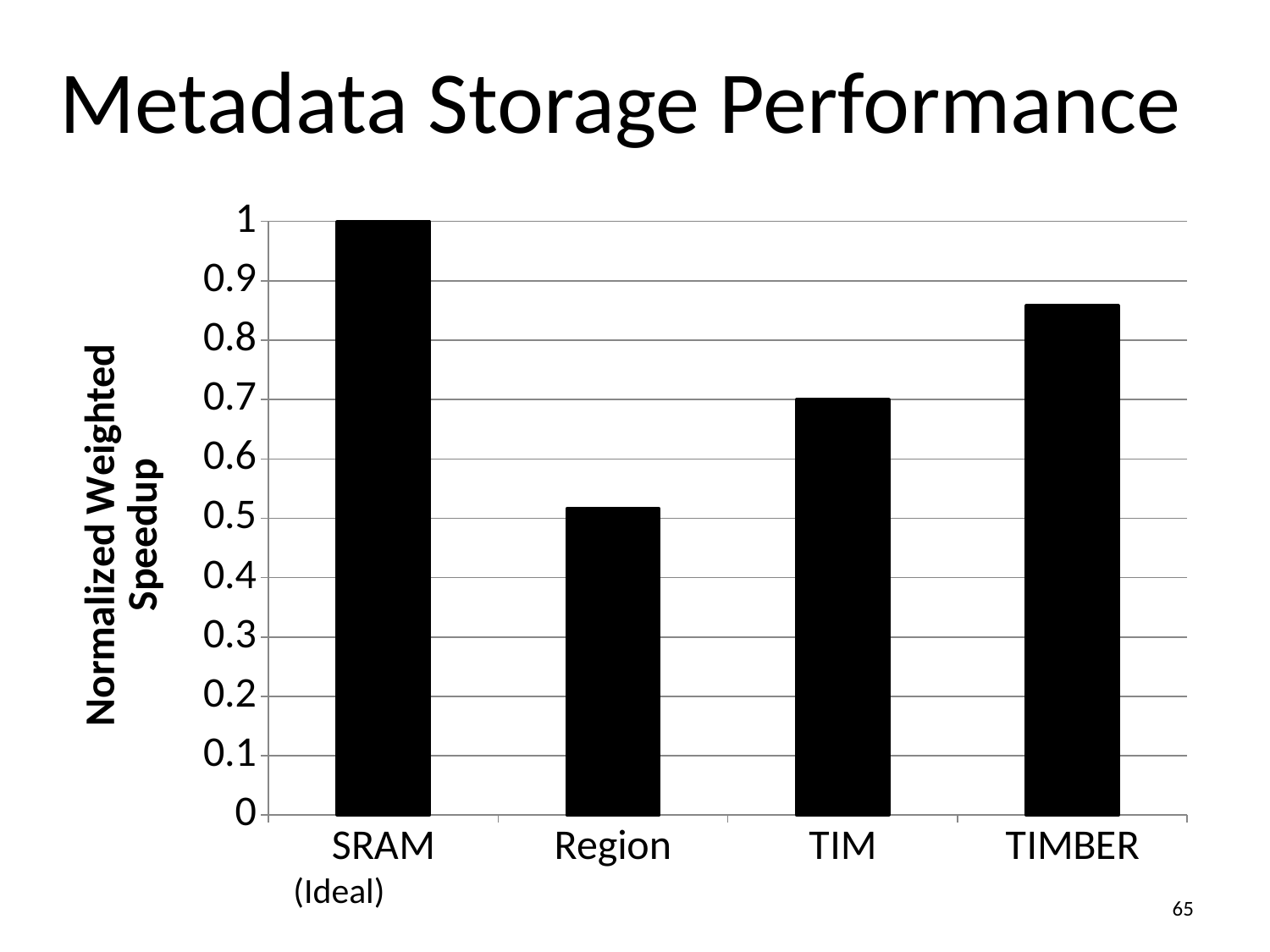
Is the value for TIMBER greater or less than 0.9? less Which has a higher normalized weighted speedup, TIM or TIMBER? TIMBER What is the label on the y axis? Normalized Weighted Speedup Which has a higher normalized weighted speedup, Region or TIM? TIM What kind of chart is shown on the slide? bar chart Which category has the highest normalized weighted speedup? SRAM (Ideal) How many categories are plotted on the x axis? 4 What is the normalized weighted speedup for SRAM (Ideal)? 1 Is the value for TIM greater or less than 0.8? less Is the value for Region greater or less than 0.6? less Which category has the lowest normalized weighted speedup? Region